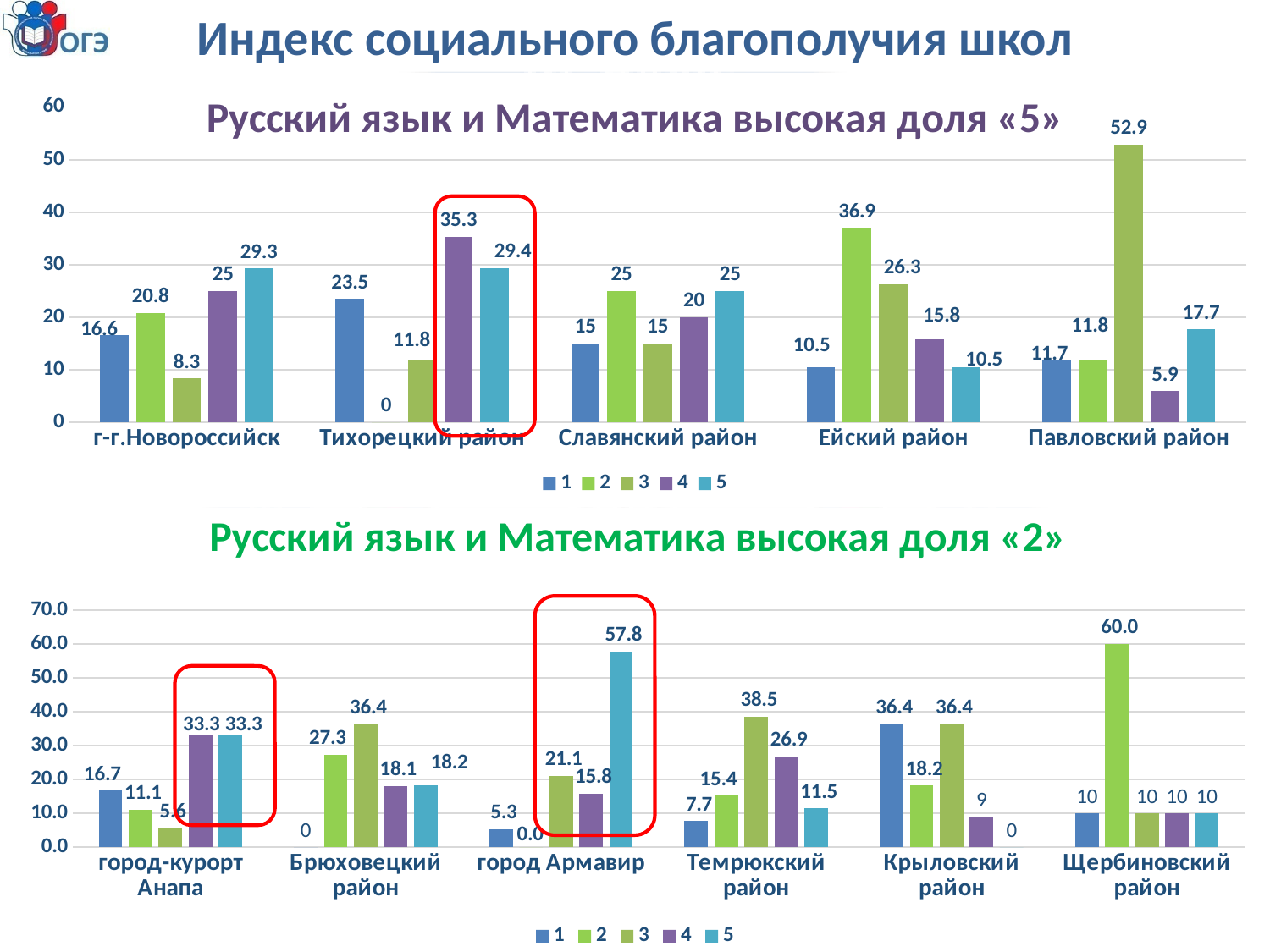
In the bottom chart (высокая доля «2»), what is the value of series 1 for Брюховецкий район? 0 In the top chart (высокая доля «5»), which category has the highest value for series 2? Ейский район In the bottom chart (высокая доля «2»), how many categories are shown on the x axis? 6 In the top chart (высокая доля «5»), what is the value of series 3 for Павловский район? 52.9 In the bottom chart (высокая доля «2»), which is larger for Темрюкский район: series 3 or series 4? series 3 What type of chart is the top chart? bar chart In the bottom chart (высокая доля «2»), what is the value of series 5 for город Армавир? 57.8 In the bottom chart (высокая доля «2»), which category has the highest value for series 2? Щербиновский район In the top chart (высокая доля «5»), what is the value of series 4 for Тихорецкий район? 35.3 In the top chart (высокая доля «5»), what is the difference between series 5 and series 1 for г-г.Новороссийск? 12.7 How many series does the legend of the bottom chart list? 5 In the top chart (высокая доля «5»), how many categories are shown on the x axis? 5